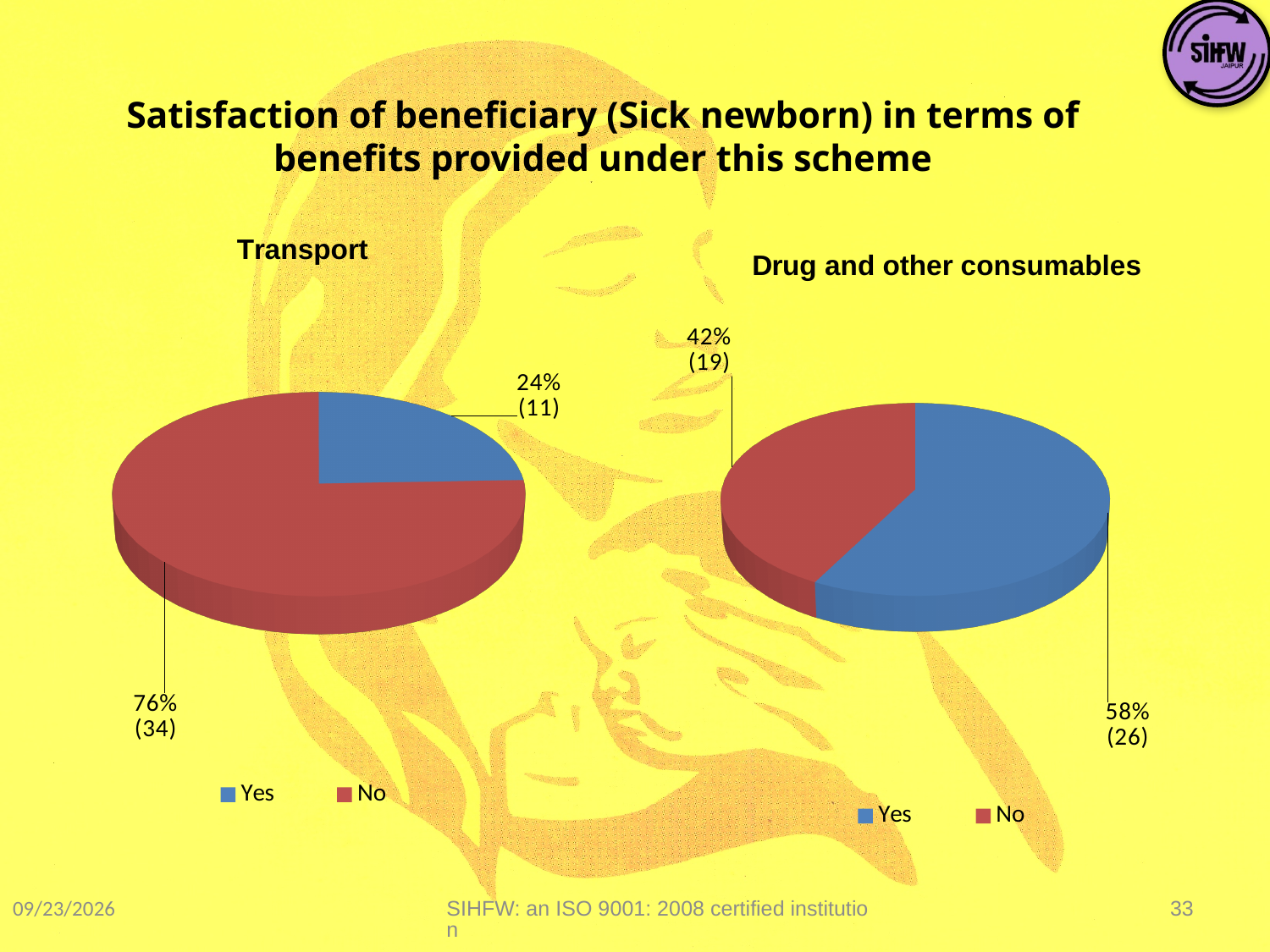
In the Transport chart, what percentage of beneficiaries answered Yes? 24% In the Transport chart, which response has the larger share? No In the Drug and other consumables chart, which response has the smaller share? No In the Transport chart, how many beneficiaries answered No? 34 In the Drug and other consumables chart, what percentage of beneficiaries answered Yes? 58% How many entries does the legend of the Drug and other consumables chart list? 2 What type of chart is used for the Transport data? Pie chart In the Drug and other consumables chart, what is the difference in percentage points between the Yes and No shares? 16 In the Transport chart, what is the difference in percentage points between the No and Yes shares? 52 In the Drug and other consumables chart, how many beneficiaries answered No? 19 In the Transport chart, what percentage of beneficiaries answered No? 76% Is the Yes share larger in the Transport chart or in the Drug and other consumables chart? Drug and other consumables